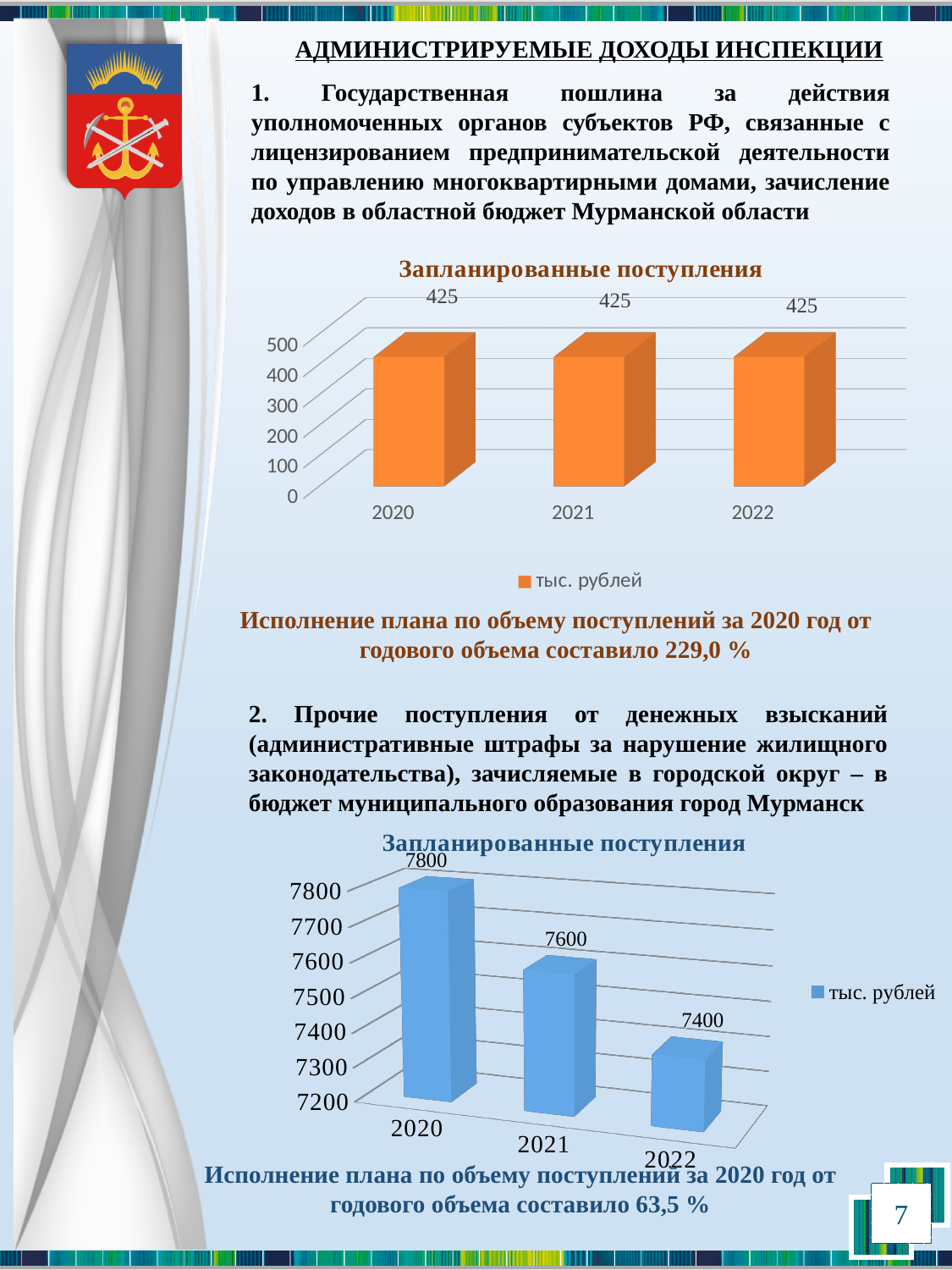
In the bottom chart (blue bars), which year has the lowest value? 2022 In the top chart (orange bars), what is the value for 2020? 425 In the top chart (orange bars), what is the difference between the values for 2021 and 2020? 0 In the bottom chart (blue bars), do the values rise or fall from 2020 to 2022? fall In the top chart (orange bars), what kind of chart is shown? bar chart In the bottom chart (blue bars), which year has the highest value? 2020 In the top chart (orange bars), what unit does the legend entry give? тыс. рублей In the bottom chart (blue bars), what is the difference between the values for 2020 and 2022? 400 In the bottom chart (blue bars), how many series does the legend list? 1 In the bottom chart (blue bars), what is the value for 2021? 7600 In the top chart (orange bars), what is the value for 2022? 425 In the top chart (orange bars), how many categories are shown on the x axis? 3